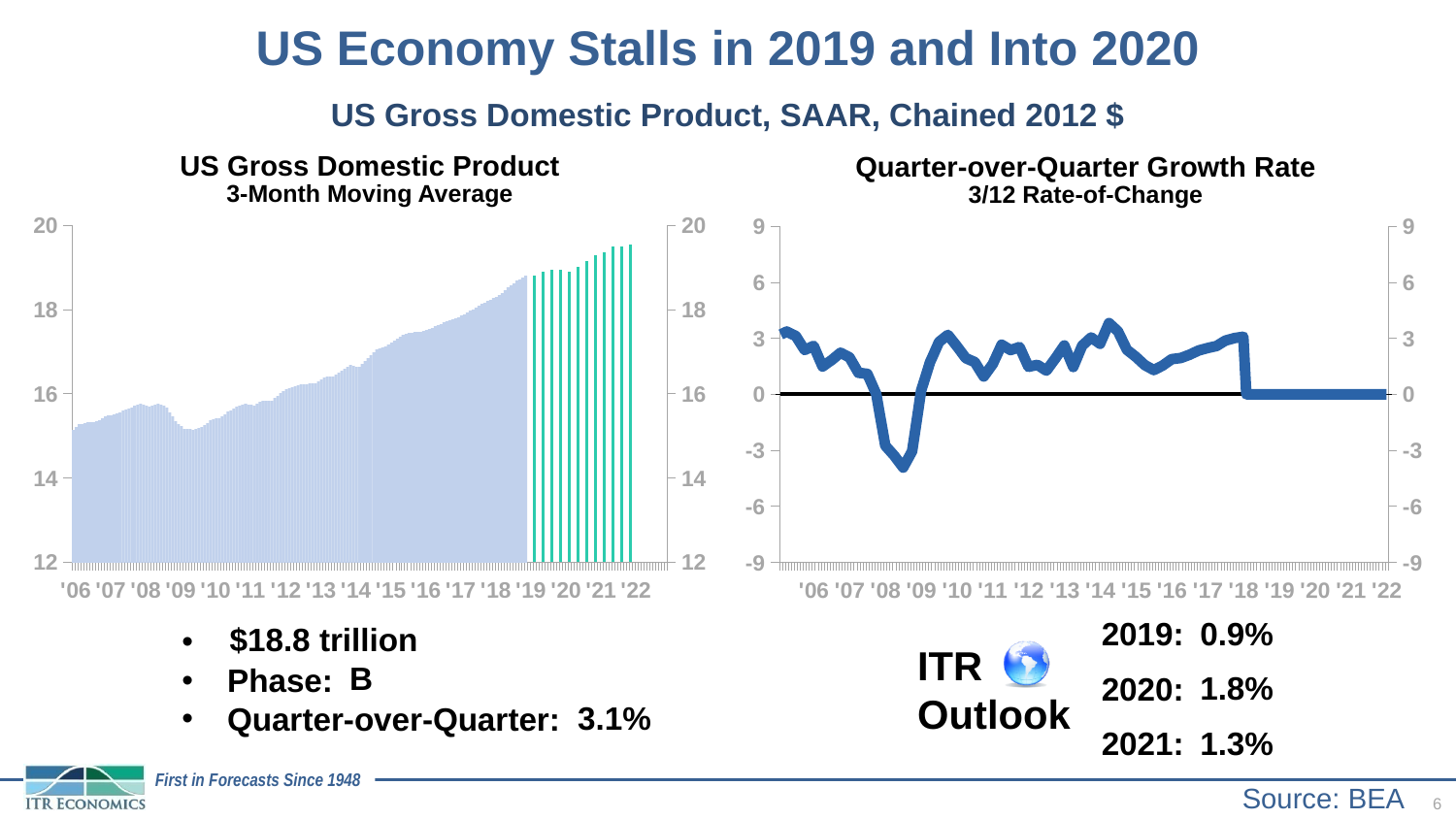
In the left chart, 'US Gross Domestic Product', do the values generally rise or fall from '06 to '22? rise What colour are the forecast bars at the right end of the left chart, 'US Gross Domestic Product'? green In the left chart, 'US Gross Domestic Product', is the value for '19 greater or less than 18? greater What is the subtitle of the right chart, 'Quarter-over-Quarter Growth Rate'? 3/12 Rate-of-Change In the right chart, 'Quarter-over-Quarter Growth Rate', is the value for '14 greater or less than 0? greater What kind of chart is the right chart, 'Quarter-over-Quarter Growth Rate 3/12 Rate-of-Change'? line chart In the left chart, 'US Gross Domestic Product', which year label on the x axis has the highest value? '22 In the right chart, 'Quarter-over-Quarter Growth Rate', is the lowest point of the line greater or less than -3? less What kind of chart is the left chart, 'US Gross Domestic Product 3-Month Moving Average'? bar chart How many year labels are shown on the x axis of the left chart, 'US Gross Domestic Product'? 17